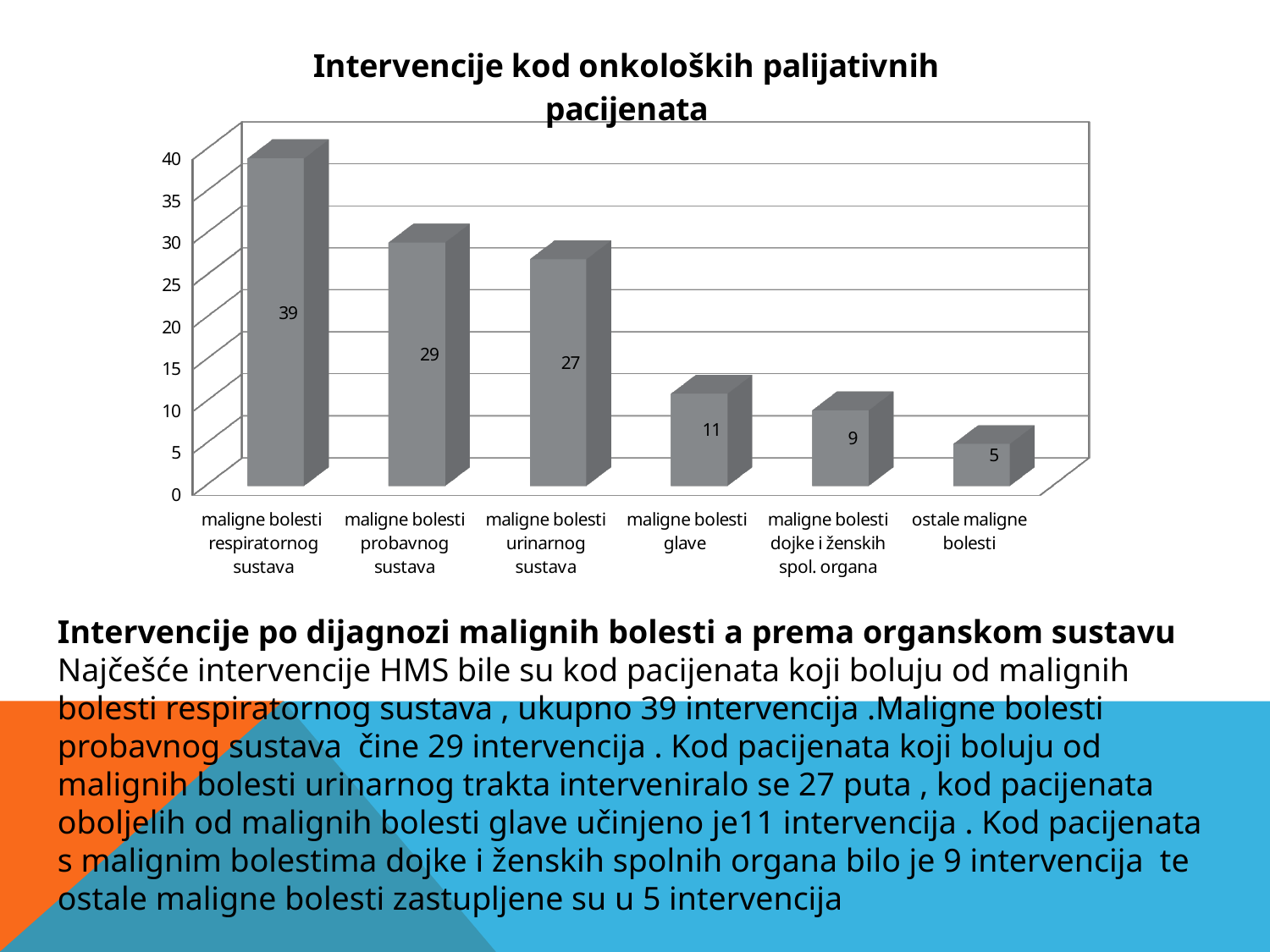
What is the value for maligne bolesti respiratornog sustava? 39 What is the value for maligne bolesti urinarnog sustava? 27 Which category has the highest value? maligne bolesti respiratornog sustava What is the value for ostale maligne bolesti? 5 What is the title of the chart? Intervencije kod onkoloških palijativnih pacijenata How many categories are shown in the chart? 6 What is the difference between the values for maligne bolesti respiratornog sustava and maligne bolesti probavnog sustava? 10 Which is larger, the value for maligne bolesti glave or the value for maligne bolesti dojke i ženskih spol. organa? maligne bolesti glave What is the value for maligne bolesti glave? 11 Which category has the lowest value? ostale maligne bolesti What is the value for maligne bolesti probavnog sustava? 29 What kind of chart is shown on the slide? bar chart